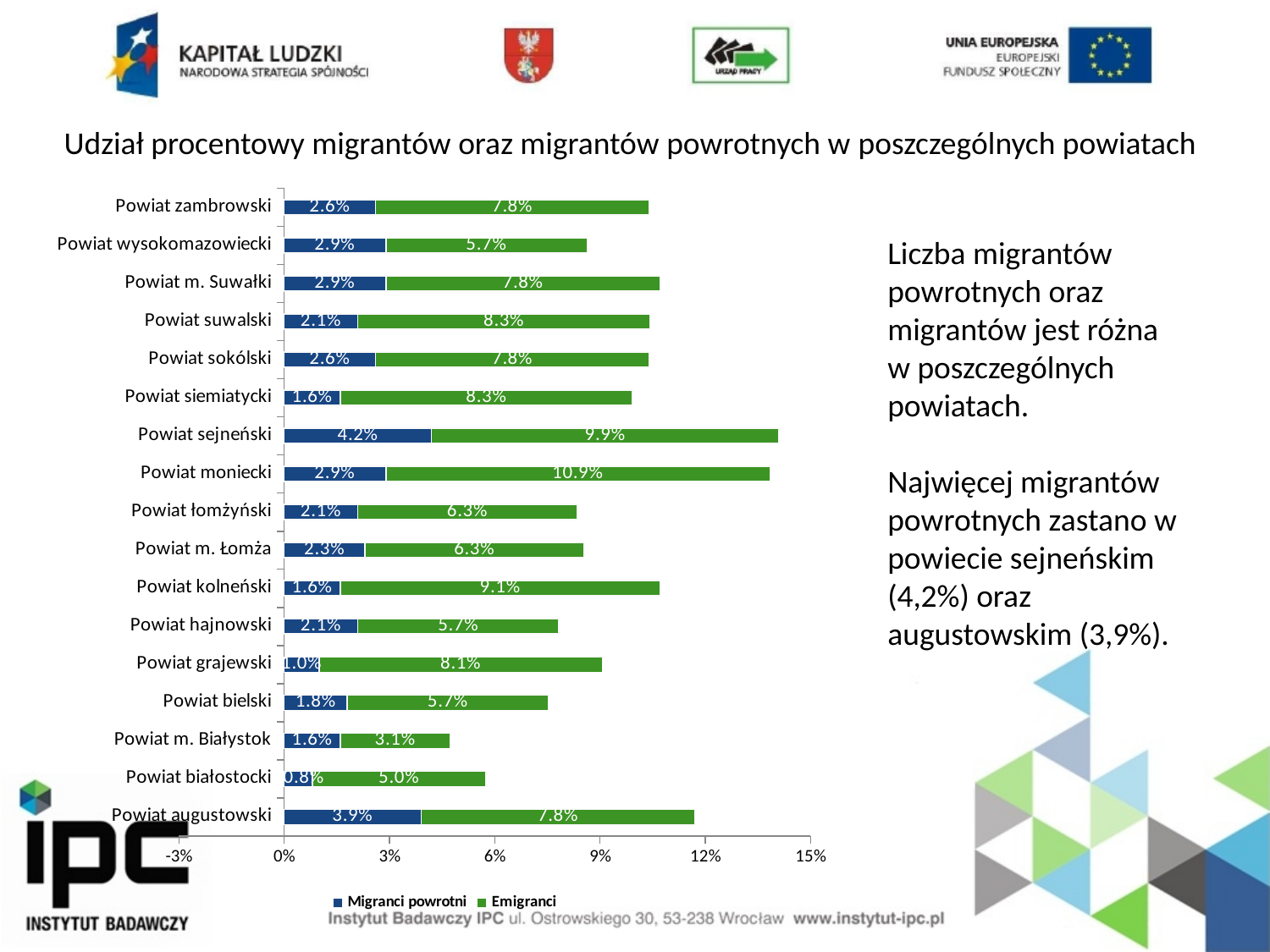
How many powiaty are shown on the chart? 17 Which powiat has the lowest Emigranci value? Powiat m. Białystok Which powiat has the highest Migranci powrotni value? Powiat sejneński What is the Emigranci value for Powiat moniecki? 10.9% Which is larger: the Emigranci value for Powiat kolneński or for Powiat grajewski? Powiat kolneński How many series does the legend list? 2 What kind of chart is shown on the slide? Stacked bar chart What is the difference between the Emigranci value for Powiat moniecki and for Powiat sejneński? 1.0 percentage points What is the Migranci powrotni value for Powiat augustowski? 3.9% Which powiat has the lowest Migranci powrotni value? Powiat białostocki What is the Migranci powrotni value for Powiat sejneński? 4.2% What is the combined total of Migranci powrotni and Emigranci for Powiat sejneński? 14.1%